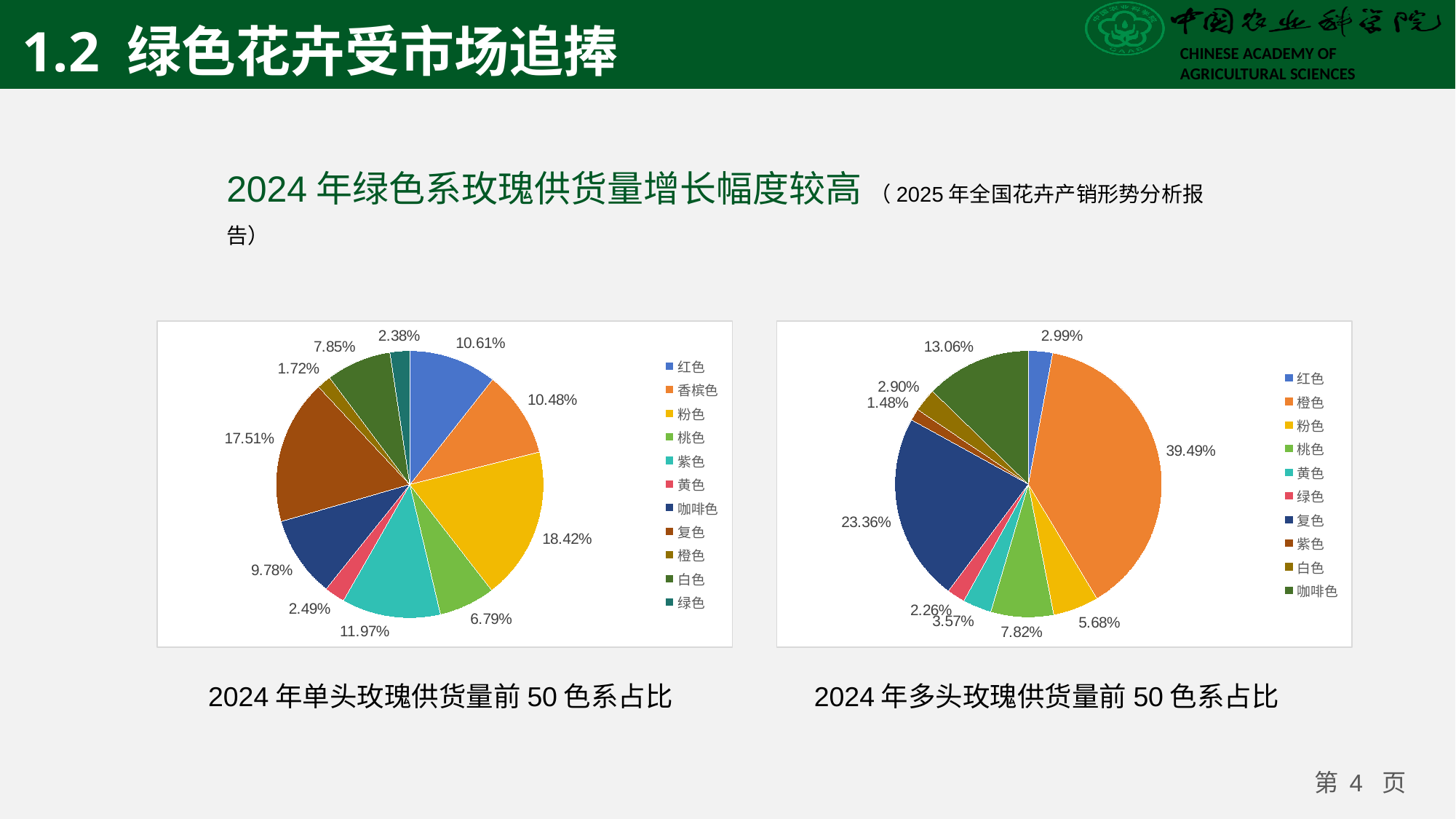
In the left chart (2024年单头玫瑰供货量前50色系占比), which colour category has the largest share? 粉色 In the right chart (2024年多头玫瑰供货量前50色系占比), which is larger, the share of 复色 or the share of 咖啡色? 复色 In the left chart (2024年单头玫瑰供货量前50色系占比), which colour category has the smallest share? 橙色 In the right chart (2024年多头玫瑰供货量前50色系占比), which colour category has the smallest share? 紫色 In the left chart (2024年单头玫瑰供货量前50色系占比), what is the difference between the shares of 紫色 and 桃色? 5.18% In the right chart (2024年多头玫瑰供货量前50色系占比), how many colour categories does the legend list? 10 In the right chart (2024年多头玫瑰供货量前50色系占比), what share does 咖啡色 have? 13.06% In the right chart (2024年多头玫瑰供货量前50色系占比), what share does 橙色 have? 39.49% In the left chart (2024年单头玫瑰供货量前50色系占比), how many colour categories does the legend list? 11 In the left chart (2024年单头玫瑰供货量前50色系占比), what share does 复色 have? 17.51% In the left chart (2024年单头玫瑰供货量前50色系占比), what share does 粉色 have? 18.42% What type of chart is used for both charts on the slide? Pie chart